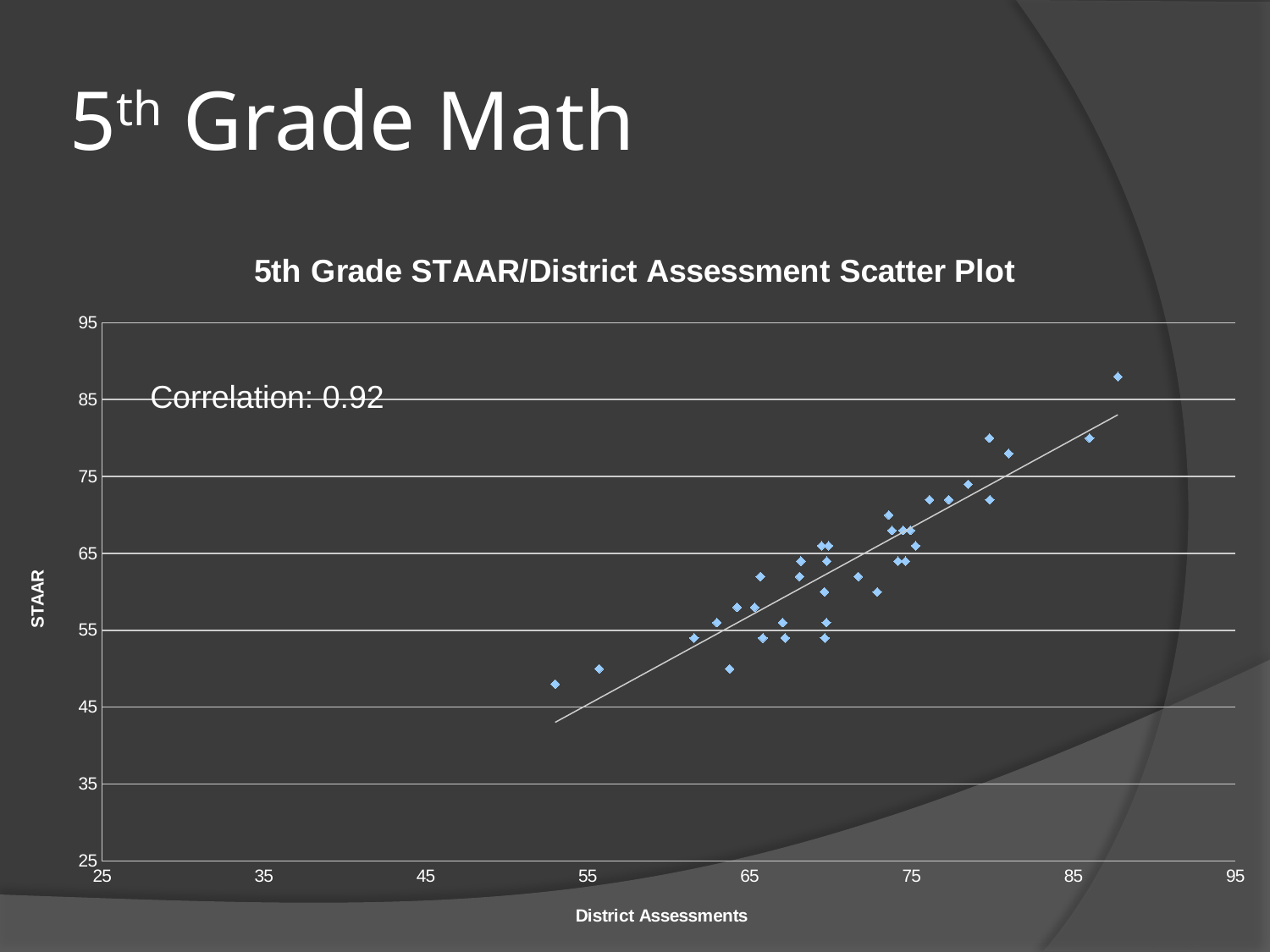
What is the highest value shown on the STAAR axis? 95 Is the STAAR value of the highest point on the chart greater or less than 85? greater Is the STAAR value of the lowest point on the chart greater or less than 45? greater What correlation value is printed on the chart? 0.92 As District Assessments scores increase, do STAAR scores generally rise or fall? Rise What is the lowest value shown on the District Assessments axis? 25 What kind of chart is shown on the slide? Scatter plot Does the point with the highest District Assessments score also have the highest STAAR score? Yes What is the label of the horizontal axis of the chart? District Assessments Is the District Assessments value of the leftmost point greater or less than 45? greater What is the title of the chart? 5th Grade STAAR/District Assessment Scatter Plot